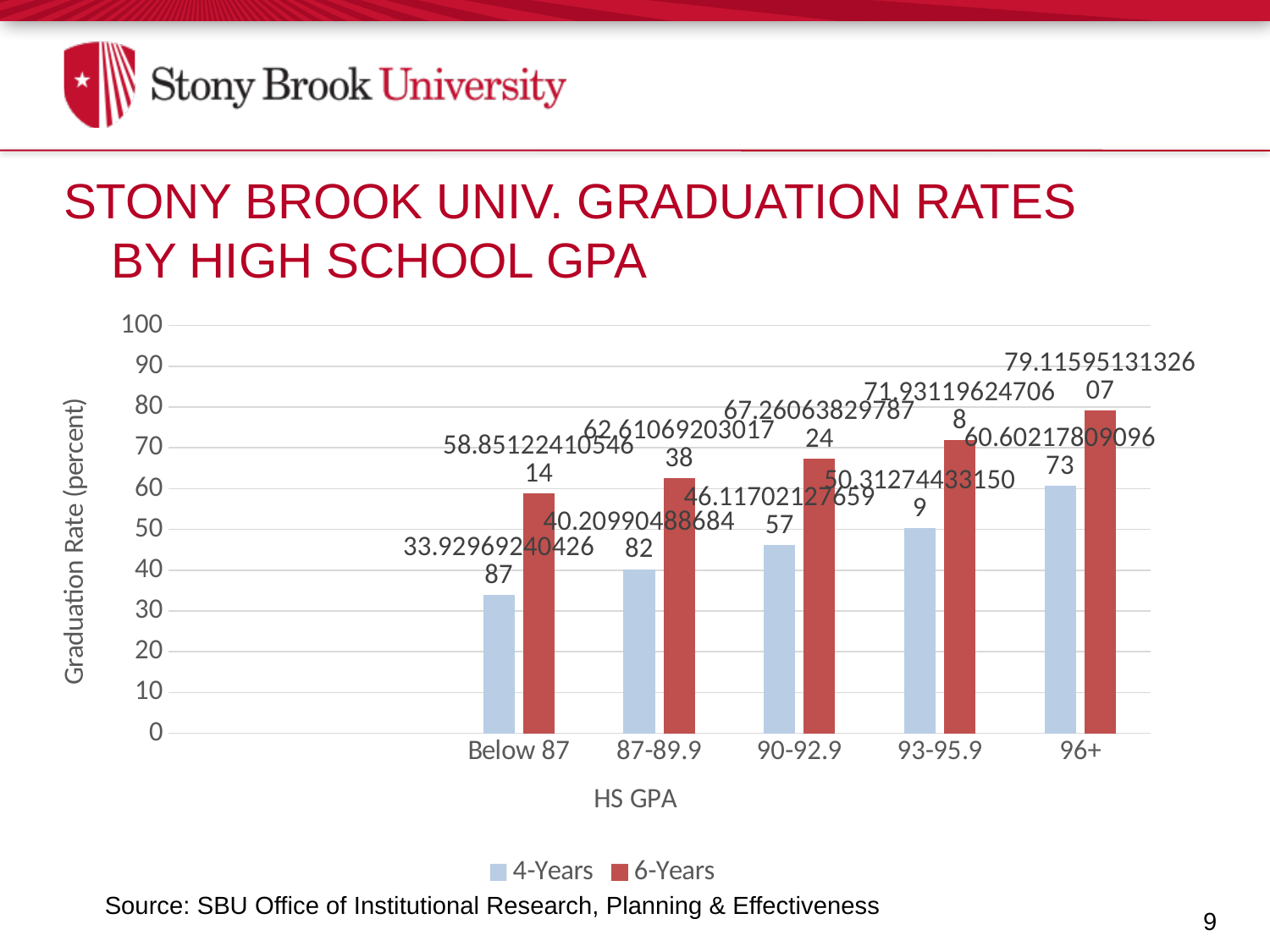
Is the 4-Years graduation rate for Below 87 greater or less than 40? less Which HS GPA category has the highest 6-Years graduation rate? 96+ How many series does the legend list? 2 Is the 4-Years graduation rate for 90-92.9 greater or less than 50? less Which HS GPA category has the lowest 4-Years graduation rate? Below 87 Which is larger for the 87-89.9 category, the 4-Years rate or the 6-Years rate? 6-Years What kind of chart is shown on the slide? bar chart What is the label of the y axis? Graduation Rate (percent) Do the 4-Years graduation rates rise or fall as HS GPA increases along the x axis? rise Is the 6-Years graduation rate for 96+ greater or less than 70? greater How many HS GPA categories are shown on the x axis? 5